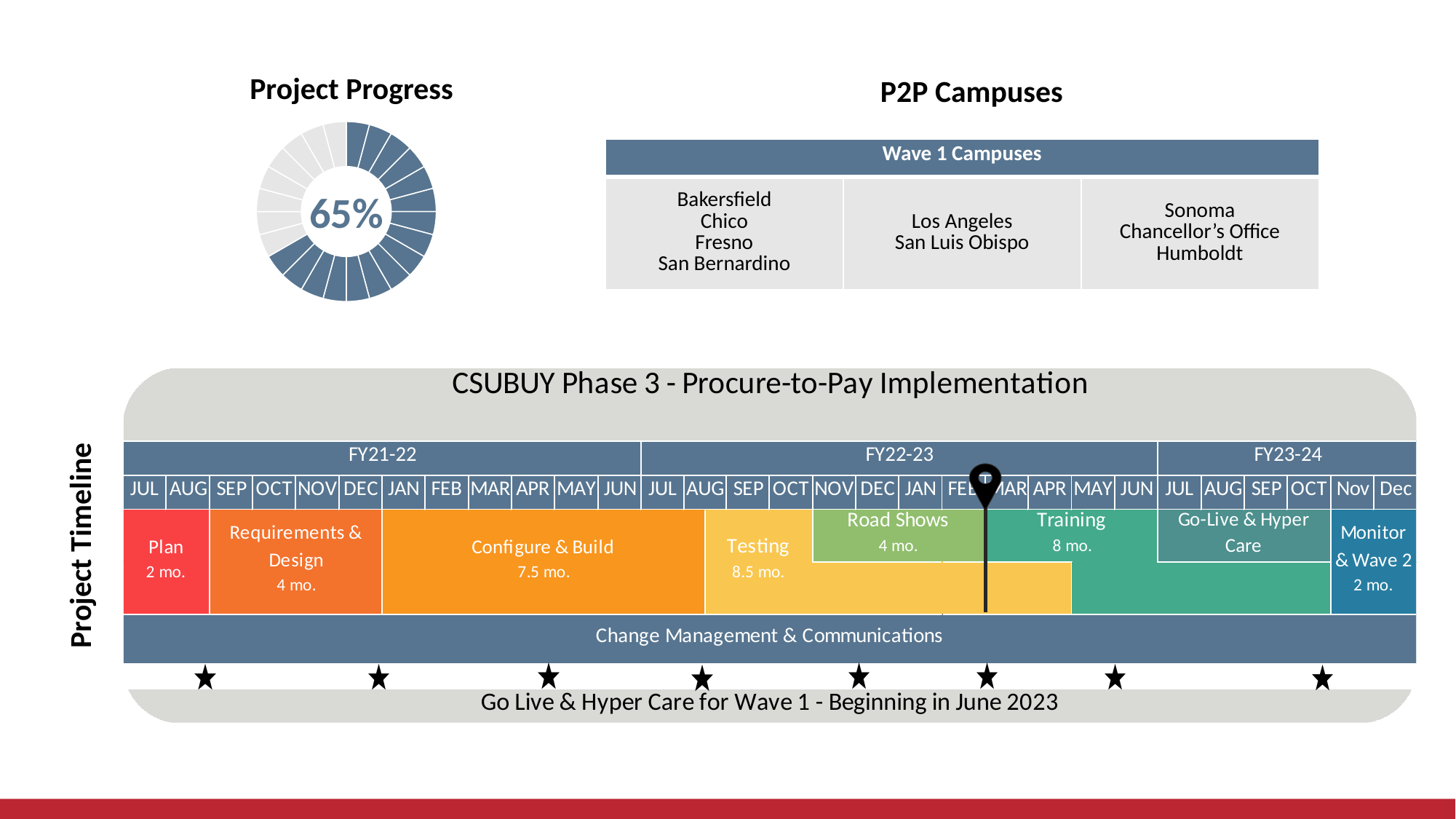
What kind of chart is the Project Progress chart? Donut chart What percentage is shown in the centre of the Project Progress chart? 65% In the Project Timeline chart, how many months longer is Training than Road Shows? 4 mo. In the Project Timeline chart, which phase is longer: Requirements & Design or Training? Training In the Project Timeline chart, how many fiscal years are shown along the top axis? 3 What is the title of the chart at the top left of the slide? Project Progress In the Project Timeline chart, how many months does the Testing phase last? 8.5 mo. In the Project Timeline chart, how many months does the Configure & Build phase last? 7.5 mo. In the Project Timeline chart, how many project phases are shown as coloured bars? 8 In the Project Progress chart, which portion is larger: the completed (blue) portion or the remaining (grey) portion? The completed (blue) portion In the Project Timeline chart, which phase has the longest labelled duration? Testing What colour represents the completed portion in the Project Progress chart? Blue